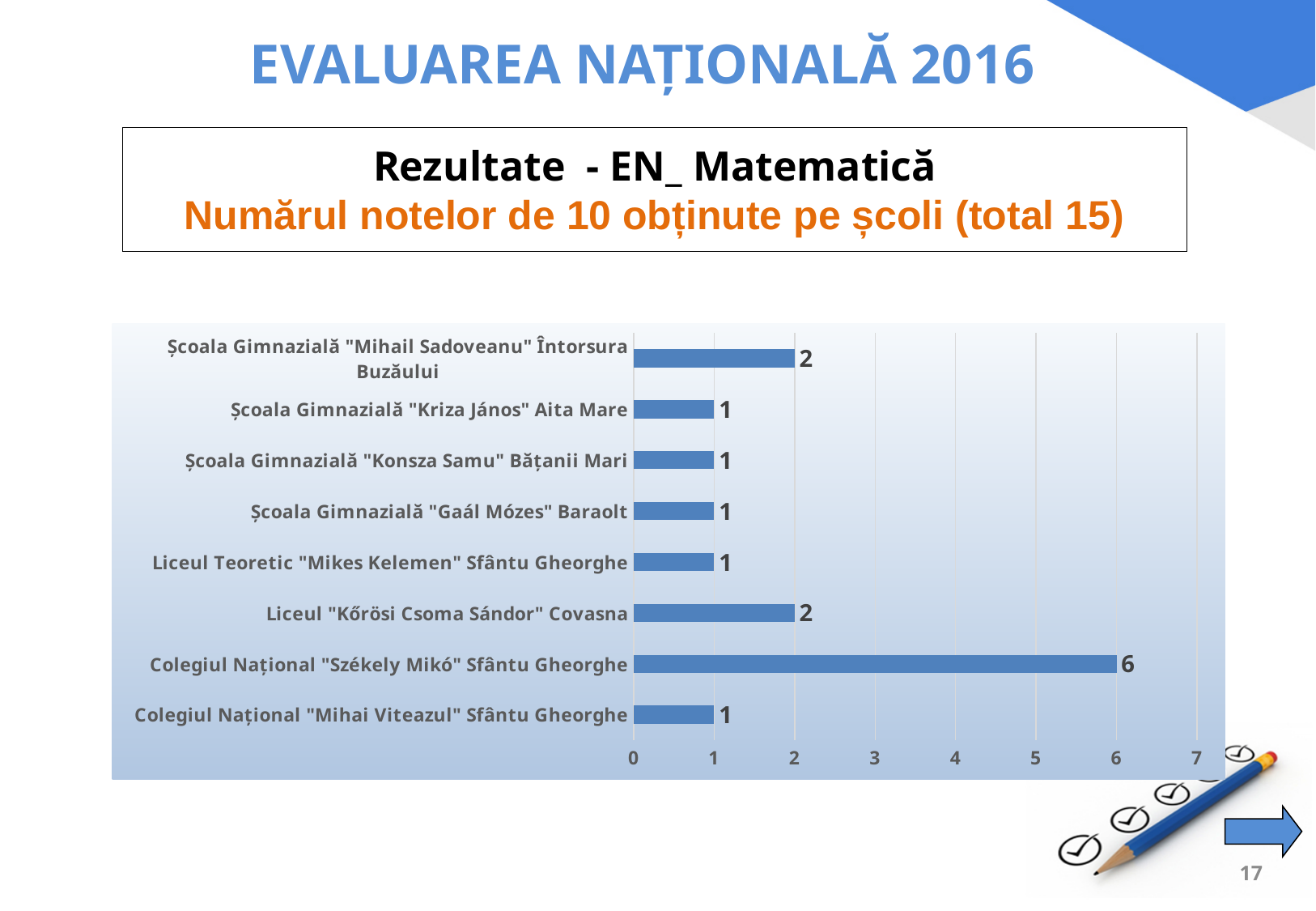
Which has a larger value: Liceul "Kőrösi Csoma Sándor" Covasna or Liceul Teoretic "Mikes Kelemen" Sfântu Gheorghe? Liceul "Kőrösi Csoma Sándor" Covasna How many schools are listed in the chart? 8 What is the value for Școala Gimnazială "Mihail Sadoveanu" Întorsura Buzăului? 2 Which school has the highest number of grades of 10? Colegiul Național "Székely Mikó" Sfântu Gheorghe What is the total number of grades of 10 stated in the chart's subtitle? 15 What kind of chart is shown on the slide? bar chart How many schools obtained exactly 1 grade of 10? 5 Is the value for Colegiul Național "Székely Mikó" Sfântu Gheorghe greater or less than 5? greater What is the difference between the values for Colegiul Național "Székely Mikó" Sfântu Gheorghe and Liceul "Kőrösi Csoma Sándor" Covasna? 4 What is the value for Liceul "Kőrösi Csoma Sándor" Covasna? 2 How many grades of 10 did Colegiul Național "Székely Mikó" Sfântu Gheorghe obtain? 6 What is the value for Colegiul Național "Mihai Viteazul" Sfântu Gheorghe? 1